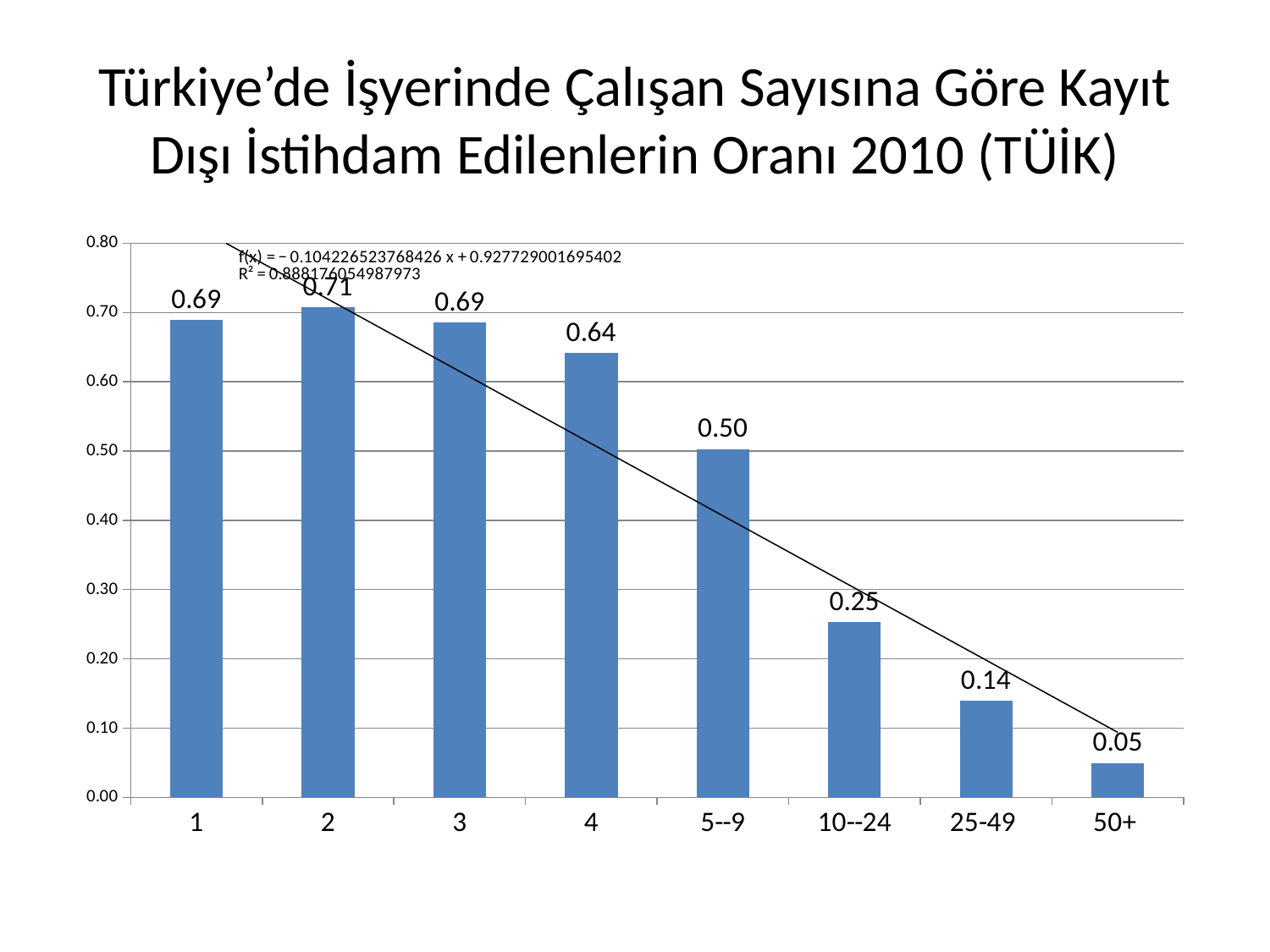
What is the value for the category 2? 0.71 Which category has the highest value? 2 Which is larger, the value for 5--9 or the value for 10--24? 5--9 Is the value for 4 greater or less than 0.60? greater What is the difference between the values for 4 and 25-49? 0.50 Do the values generally rise or fall from left to right along the x axis? fall What is the value for the category 50+? 0.05 What is the value for the category 5--9? 0.50 What kind of chart is shown on the slide? bar chart How many categories are shown on the x axis? 8 Which category has the lowest value? 50+ What is the value for the category 10--24? 0.25